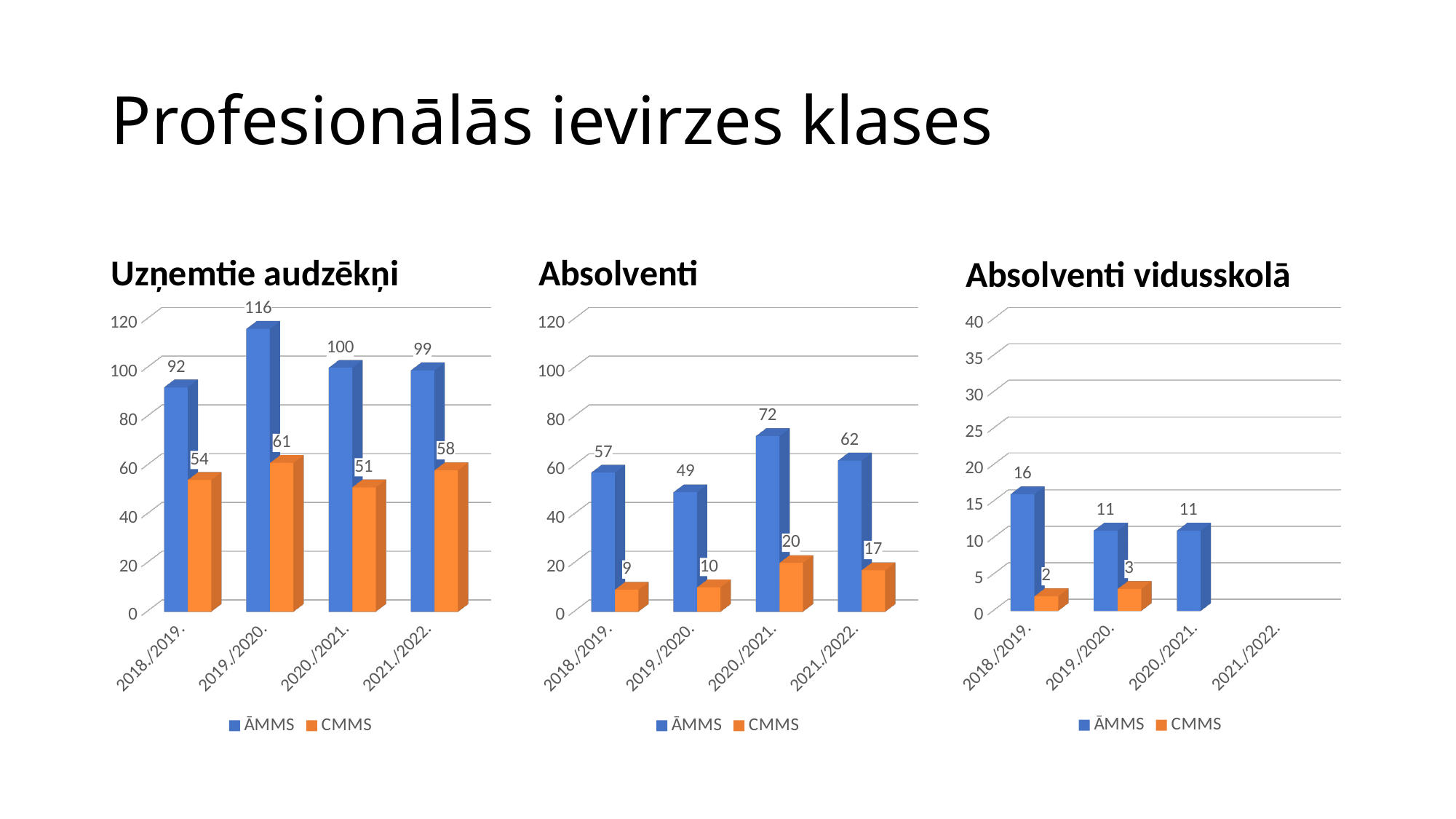
In the 'Absolventi vidusskolā' chart, what is the CMMS value for 2019./2020.? 3 In the 'Absolventi' chart, which is larger: the ĀMMS value for 2018./2019. or for 2019./2020.? 2018./2019. What kind of chart is the 'Absolventi' chart? Bar chart In the 'Absolventi' chart, what is the difference between the CMMS values for 2020./2021. and 2021./2022.? 3 In the 'Uzņemtie audzēkņi' chart, what is the difference between the ĀMMS and CMMS values for 2018./2019.? 38 In the 'Uzņemtie audzēkņi' chart, what is the CMMS value for 2020./2021.? 51 In the 'Absolventi' chart, what is the ĀMMS value for 2020./2021.? 72 In the 'Uzņemtie audzēkņi' chart, what is the ĀMMS value for 2019./2020.? 116 How many series does the legend of the 'Absolventi vidusskolā' chart list? 2 In the 'Uzņemtie audzēkņi' chart, which year has the highest ĀMMS value? 2019./2020. In the 'Absolventi vidusskolā' chart, what is the ĀMMS value for 2018./2019.? 16 In the 'Absolventi' chart, which year has the lowest CMMS value? 2018./2019.